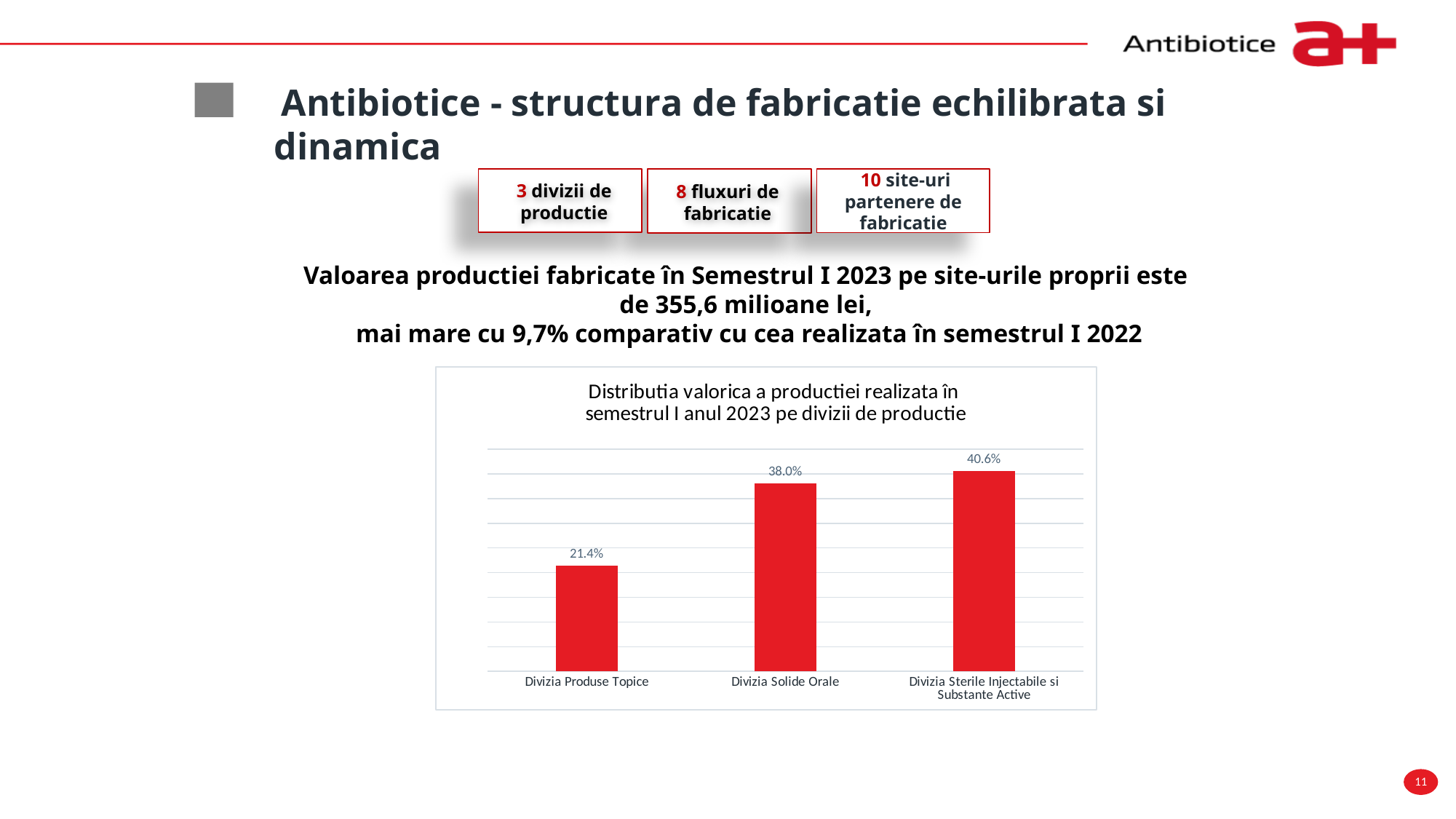
What kind of chart is shown on the slide? Bar chart Which division has the lowest share of production value? Divizia Produse Topice What is the value for Divizia Sterile Injectabile si Substante Active? 40.6% Which is larger: the value for Divizia Solide Orale or Divizia Produse Topice? Divizia Solide Orale What is the value for Divizia Produse Topice? 21.4% What is the title of the chart? Distributia valorica a productiei realizata în semestrul I anul 2023 pe divizii de productie Which division has the highest share of production value? Divizia Sterile Injectabile si Substante Active What is the difference between the values for Divizia Sterile Injectabile si Substante Active and Divizia Solide Orale? 2.6% Do the values rise or fall from left to right across the divisions? Rise What is the difference between the values for Divizia Solide Orale and Divizia Produse Topice? 16.6% How many divisions are shown in the chart? 3 What is the value for Divizia Solide Orale? 38.0%